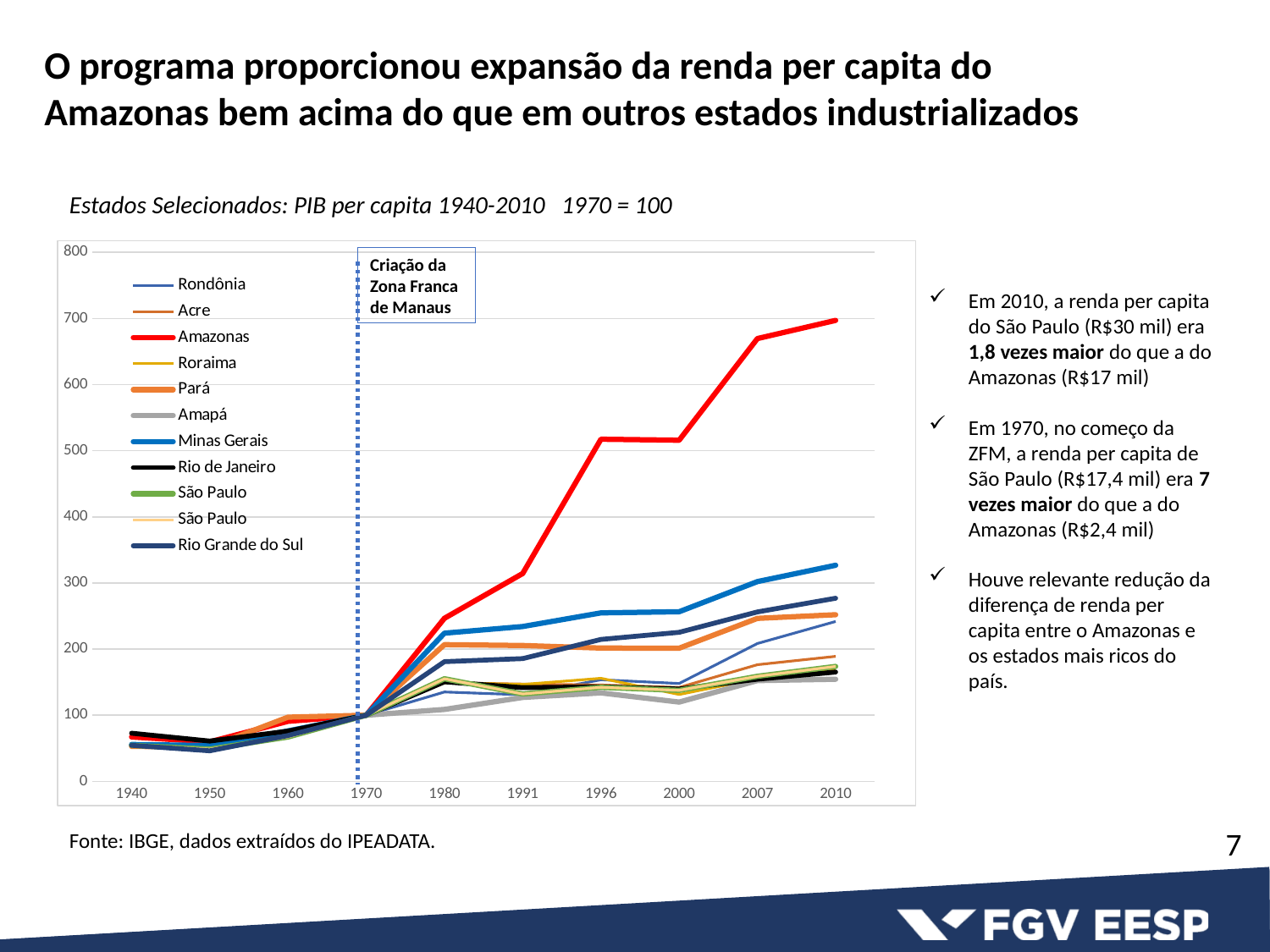
How many series does the chart legend list? 11 What kind of chart is shown on the slide? line chart Is the value for Amazonas in 2010 greater or less than 600? greater Which state has the highest value in 2010? Amazonas How many years are marked on the x axis of the chart? 10 Is the value for Amapá in 2010 greater or less than 200? less What event does the dashed vertical line at 1970 mark? Criação da Zona Franca de Manaus Is the value for Amazonas in 1996 greater or less than 400? greater Does the Amazonas line rise or fall between 1970 and 2010? rise In 2010, which is larger: the value for Minas Gerais or the value for Pará? Minas Gerais What is the index value of Amazonas in 1970? 100